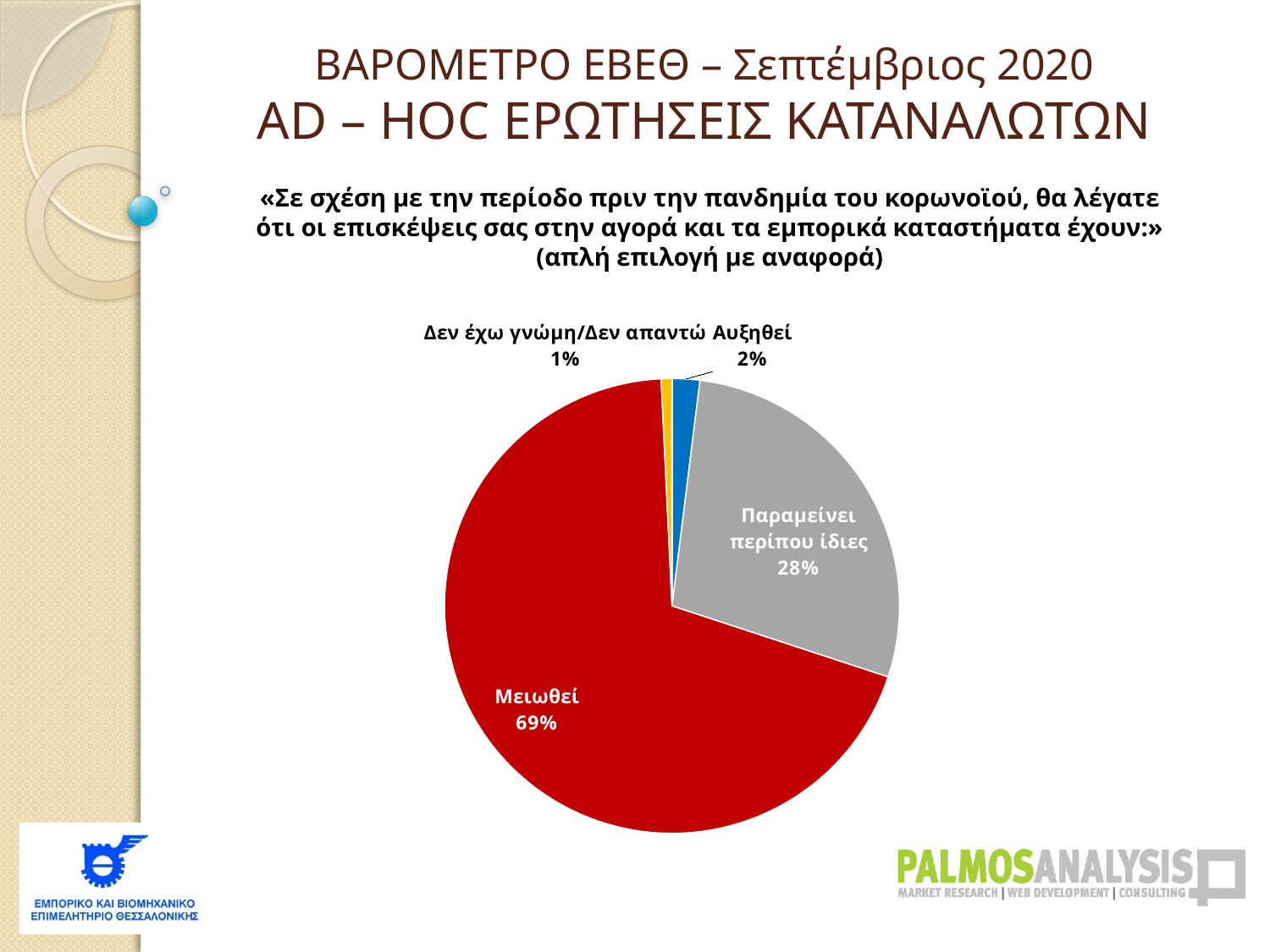
What percentage of respondents answered "Αυξηθεί"? 2% Which is larger, the share for "Αυξηθεί" or the share for "Παραμείνει περίπου ίδιες"? Παραμείνει περίπου ίδιες What is the difference in percentage points between "Μειωθεί" and "Παραμείνει περίπου ίδιες"? 41 percentage points How many slices does the pie chart have? 4 Which response has the largest share of the pie? Μειωθεί What kind of chart is shown on the slide? pie chart What percentage of respondents answered "Μειωθεί"? 69% What percentage of respondents answered "Δεν έχω γνώμη/Δεν απαντώ"? 1% What percentage of respondents answered "Παραμείνει περίπου ίδιες"? 28% What colour is the "Παραμείνει περίπου ίδιες" slice? grey What colour is the "Μειωθεί" slice? red Which response has the smallest share of the pie? Δεν έχω γνώμη/Δεν απαντώ